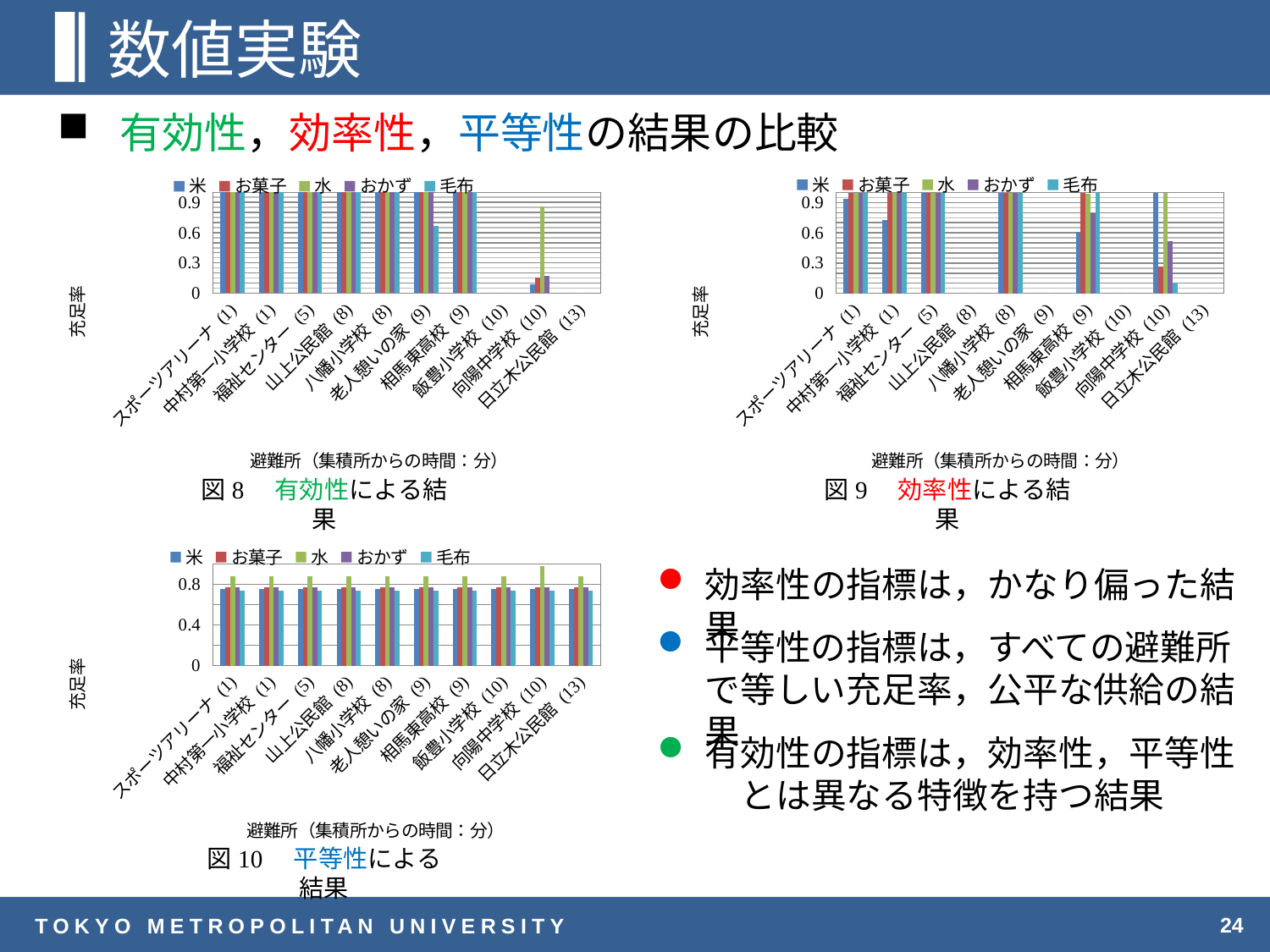
How many series does the legend of 図 9 (効率性による結果) list? 5 What kind of chart is 図 8 (有効性による結果)? bar chart How many shelter categories are shown on the x axis of 図 10 (平等性による結果)? 10 In 図 9 (効率性による結果), is the value for 米 at 中村第一小学校 (1) greater or less than 0.3? greater In 図 9 (効率性による結果), which is larger at 中村第一小学校 (1): the value for 米 or the value for お菓子? お菓子 In 図 9 (効率性による結果), is the value for 米 at 向陽中学校 (10) greater or less than 0.6? greater How many charts are shown on the slide? 3 What are the legend entries of 図 10 (平等性による結果)? 米, お菓子, 水, おかず, 毛布 What is the highest tick value shown on the y axis of 図 10 (平等性による結果)? 0.8 In 図 8 (有効性による結果), is the value for 米 at スポーツアリーナ (1) greater or less than 0.6? greater What is the label of the y axis of 図 8 (有効性による結果)? 充足率